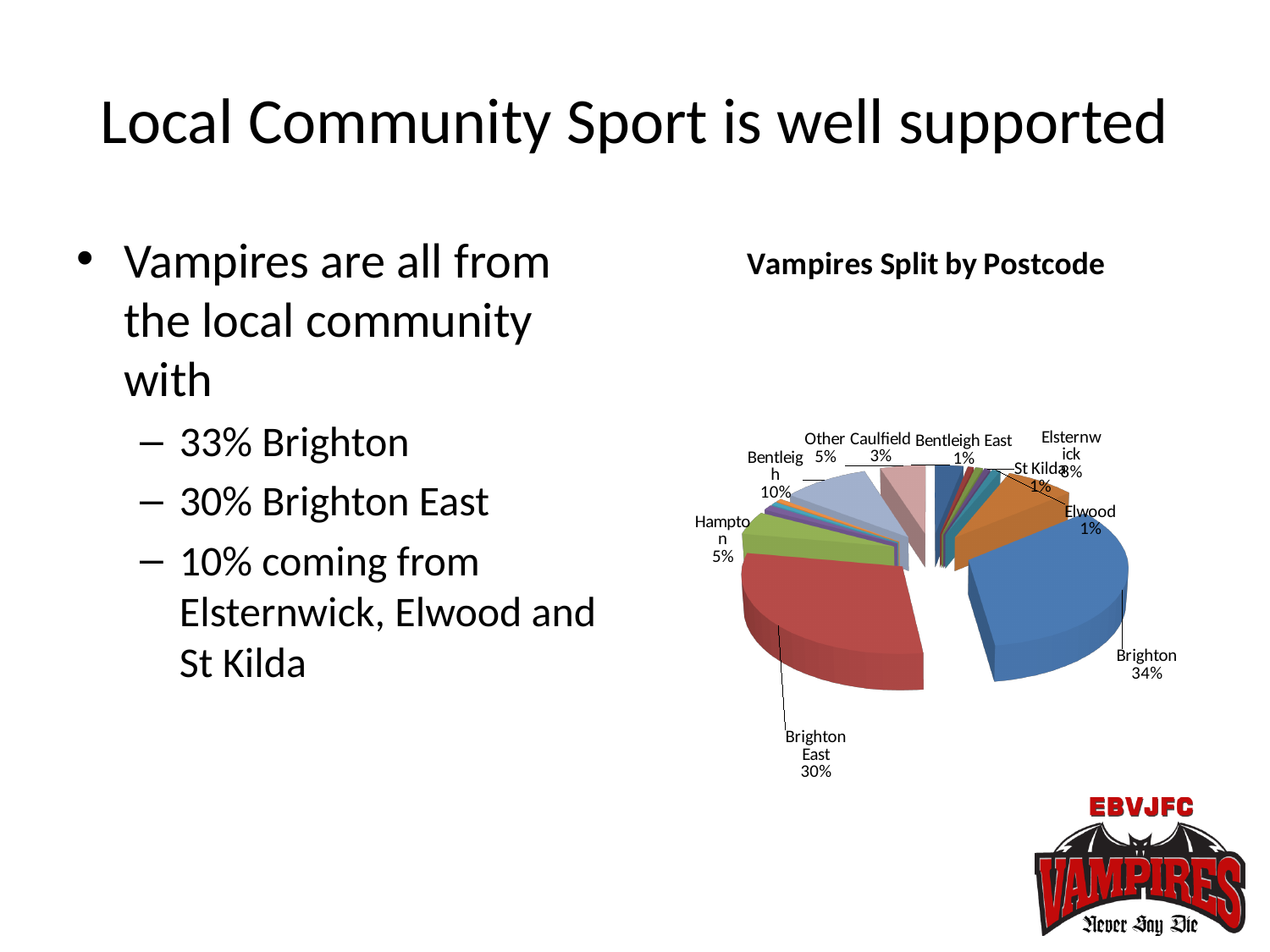
Which postcode area has the largest slice of the pie? Brighton What is the title of the chart? Vampires Split by Postcode What percentage is shown for Hampton? 5% What percentage is shown for Elsternwick? 8% What kind of chart is shown on the slide? Pie chart What share of the pie does Brighton have in the Vampires Split by Postcode chart? 34% What percentage is shown for Caulfield? 3% What is the difference in percentage points between Brighton and Brighton East? 4% Which has a larger share, Bentleigh or Elsternwick? Bentleigh What percentage is shown for Brighton East? 30% What percentage is shown for Bentleigh? 10% Which has a larger share, Hampton or Caulfield? Hampton